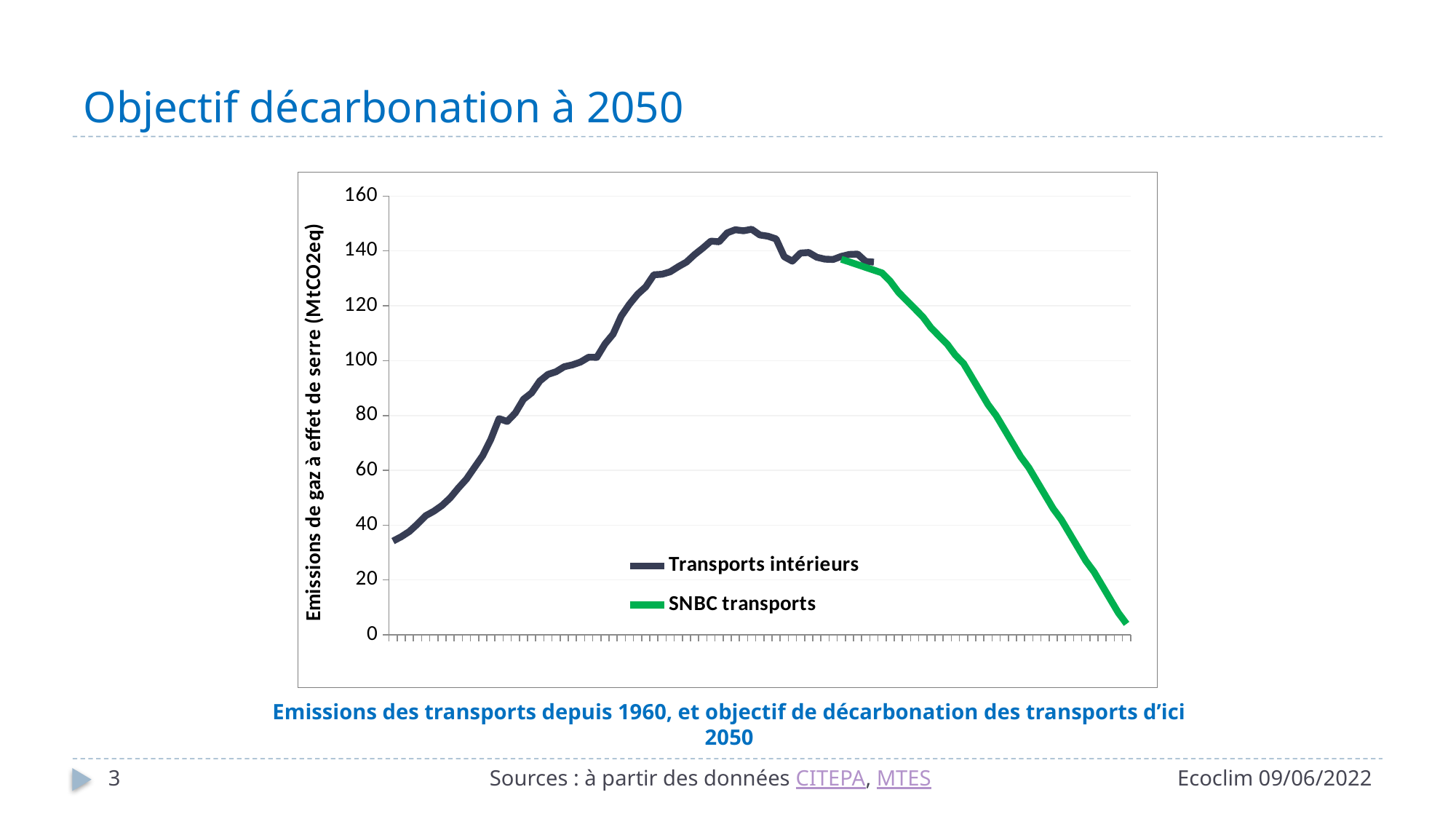
Is the starting value of the SNBC transports line greater or less than 120? greater Does the SNBC transports line rise or fall along the x axis? fall Is the final value of the SNBC transports line greater or less than 20? less Is the first value of the Transports intérieurs line greater or less than 40? less What is the highest value shown on the vertical axis of the chart? 160 What is the label of the vertical axis of the chart? Emissions de gaz à effet de serre (MtCO2eq) Which series reaches the higher value on the chart, Transports intérieurs or SNBC transports? Transports intérieurs How many series does the chart legend list? 2 What are the two series named in the chart legend? Transports intérieurs, SNBC transports What kind of chart is shown on the slide? line chart